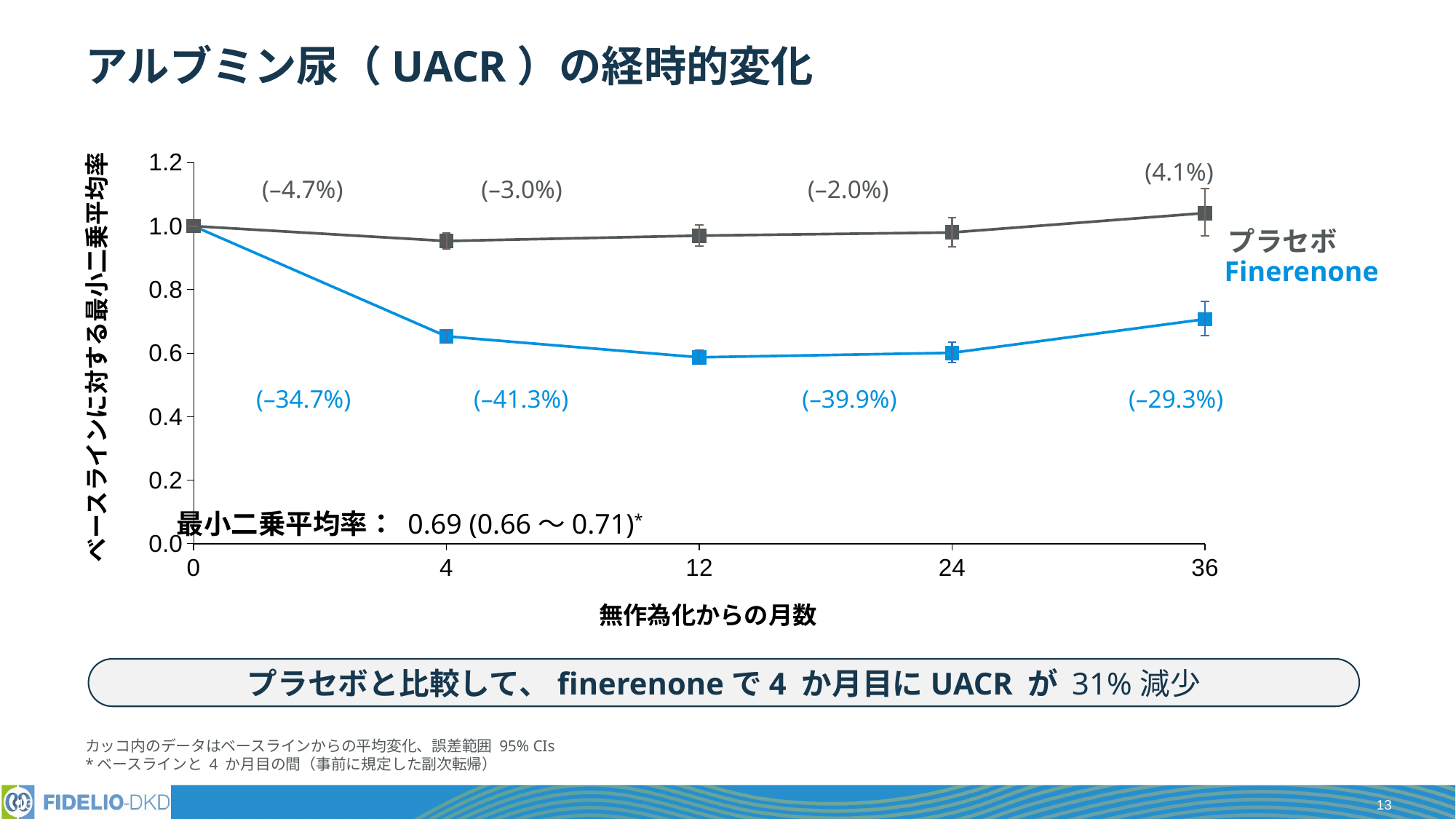
How many series are plotted on the chart? 2 What is the percentage change from baseline shown for プラセボ at 4 months? –4.7% What is the x-axis title of the chart? 無作為化からの月数 At 12 months, which series has the higher value: プラセボ or Finerenone? プラセボ At which month does the Finerenone series show its largest percentage reduction from baseline? 12 Is the value for Finerenone at 4 months greater or less than 0.6? greater What is the percentage change from baseline shown for Finerenone at 4 months? –34.7% Does the Finerenone series rise or fall between 24 and 36 months? rise What kind of chart is shown on the slide? line chart What is the percentage change from baseline shown for プラセボ at 36 months? 4.1% What is the percentage change from baseline shown for Finerenone at 12 months? –41.3% How many time points are plotted along the x axis? 5